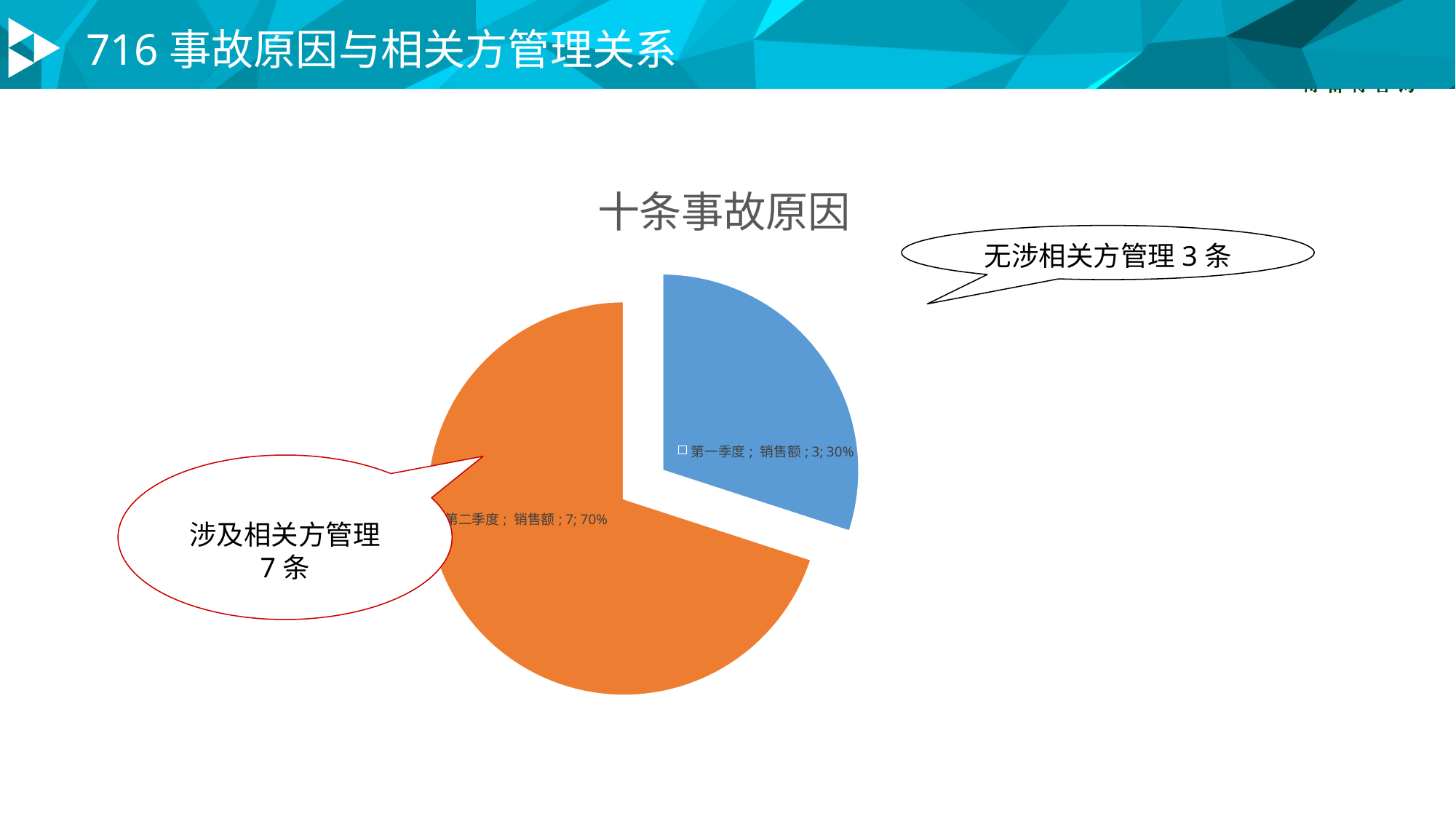
Which slice is the largest in the pie chart? 第二季度 Which slice is the smallest in the pie chart? 第一季度 What is the difference between the values for 第二季度 and 第一季度? 4 What share of the pie does 第一季度 represent? 30% How many slices does the pie chart have? 2 Which is larger, the value for 第一季度 or 第二季度? 第二季度 What is the value shown for 第一季度 in the pie chart? 3 What is the value shown for 第二季度 in the pie chart? 7 What is the title of the chart? 十条事故原因 What colour is the 第一季度 slice in the pie chart? blue What share of the pie does 第二季度 represent? 70% What type of chart is shown on the slide? pie chart